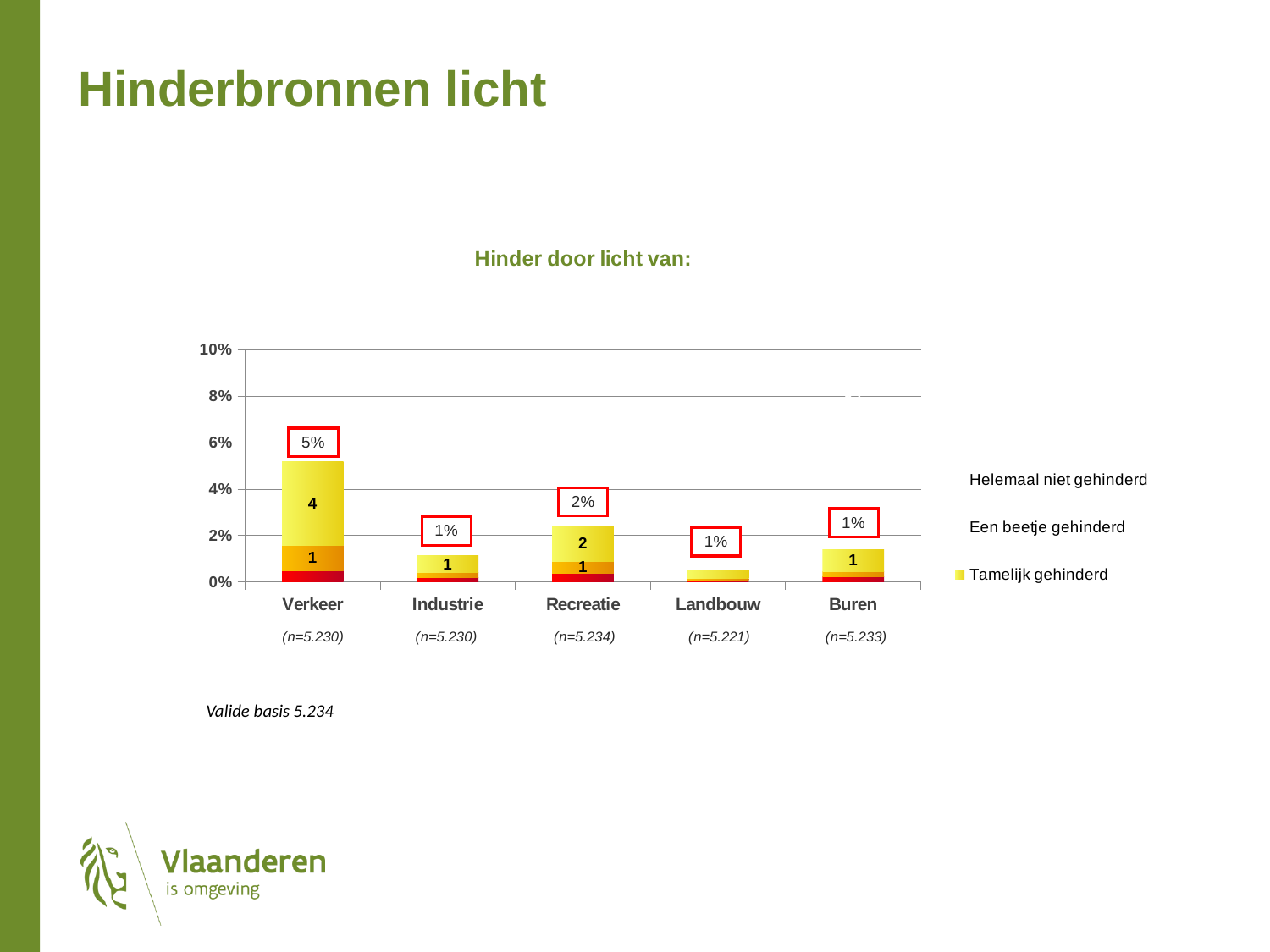
Which category has the lowest total bar in the chart? Landbouw What value is printed in the large yellow segment of the Verkeer bar? 4 How many categories are shown on the x axis of the chart? 5 What is the boxed percentage shown above the Recreatie bar? 2% Is the total bar for Landbouw greater or less than 2%? less What is the title of the chart? Hinder door licht van: Which category has the highest total bar in the chart? Verkeer Is the total bar for Verkeer greater or less than 4%? greater What is the boxed percentage shown above the Verkeer bar? 5% What kind of chart is shown on the slide? Stacked bar chart What is the difference between the boxed percentages for Verkeer and Recreatie? 3 percentage points Which has a larger boxed percentage, Verkeer or Industrie? Verkeer